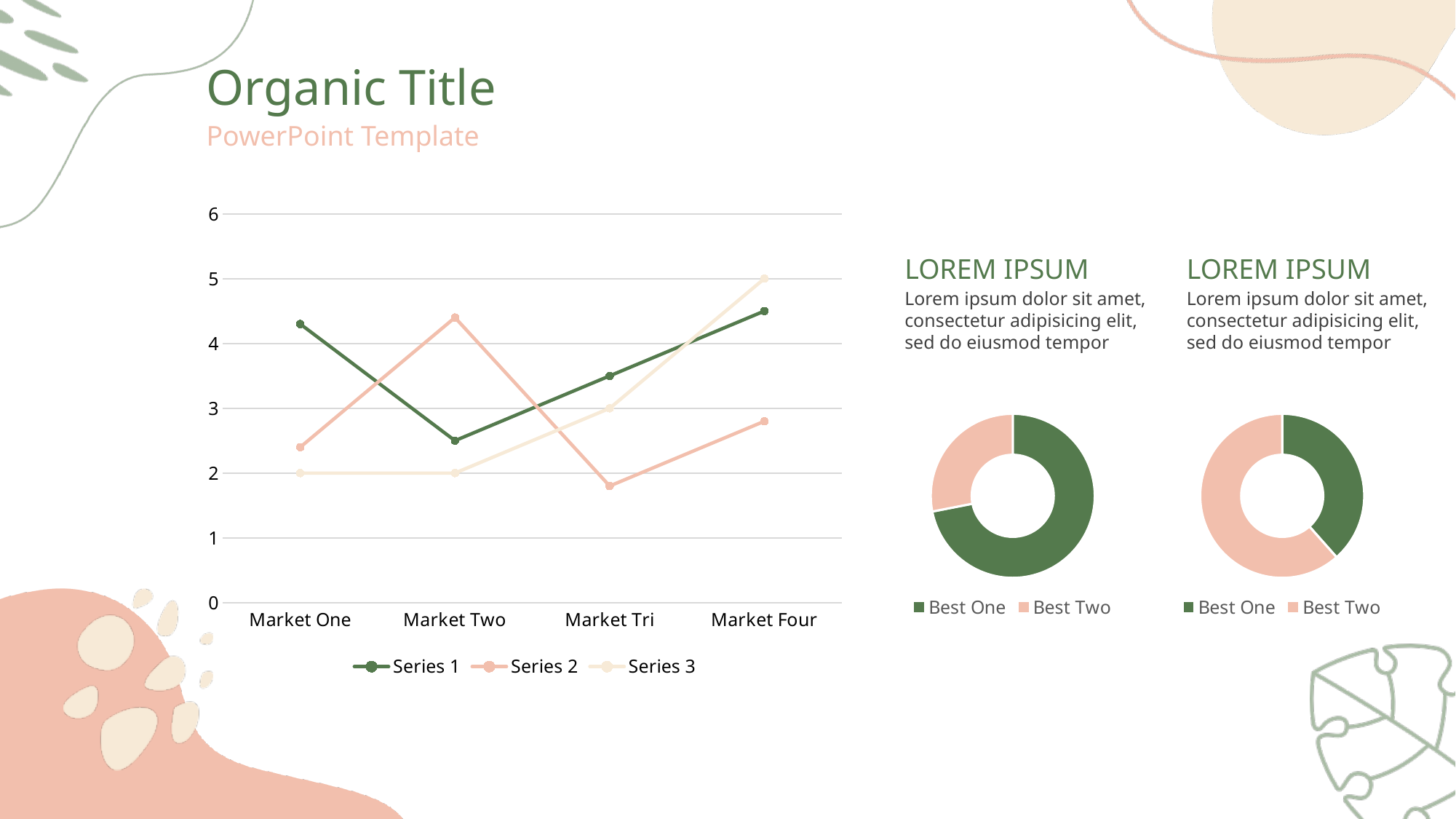
In the line chart, what is the value of Series 3 at Market One? 2 In the line chart, does Series 3 rise or fall from Market Two to Market Four? rise How many categories are shown on the x axis of the line chart? 4 In the left doughnut chart, which slice is larger, Best One or Best Two? Best One In the line chart, which series has the highest value at Market Two? Series 2 In the line chart, is the value of Series 1 at Market One greater or less than 4? greater In the line chart, is the value of Series 2 at Market Tri greater or less than 2? less What kind of chart is the chart on the left of the slide? line chart In the right doughnut chart, which slice is larger, Best One or Best Two? Best Two In the line chart, which series has the lowest value at Market Four? Series 2 In the line chart, what is the value of Series 3 at Market Four? 5 How many series does the legend of the line chart list? 3